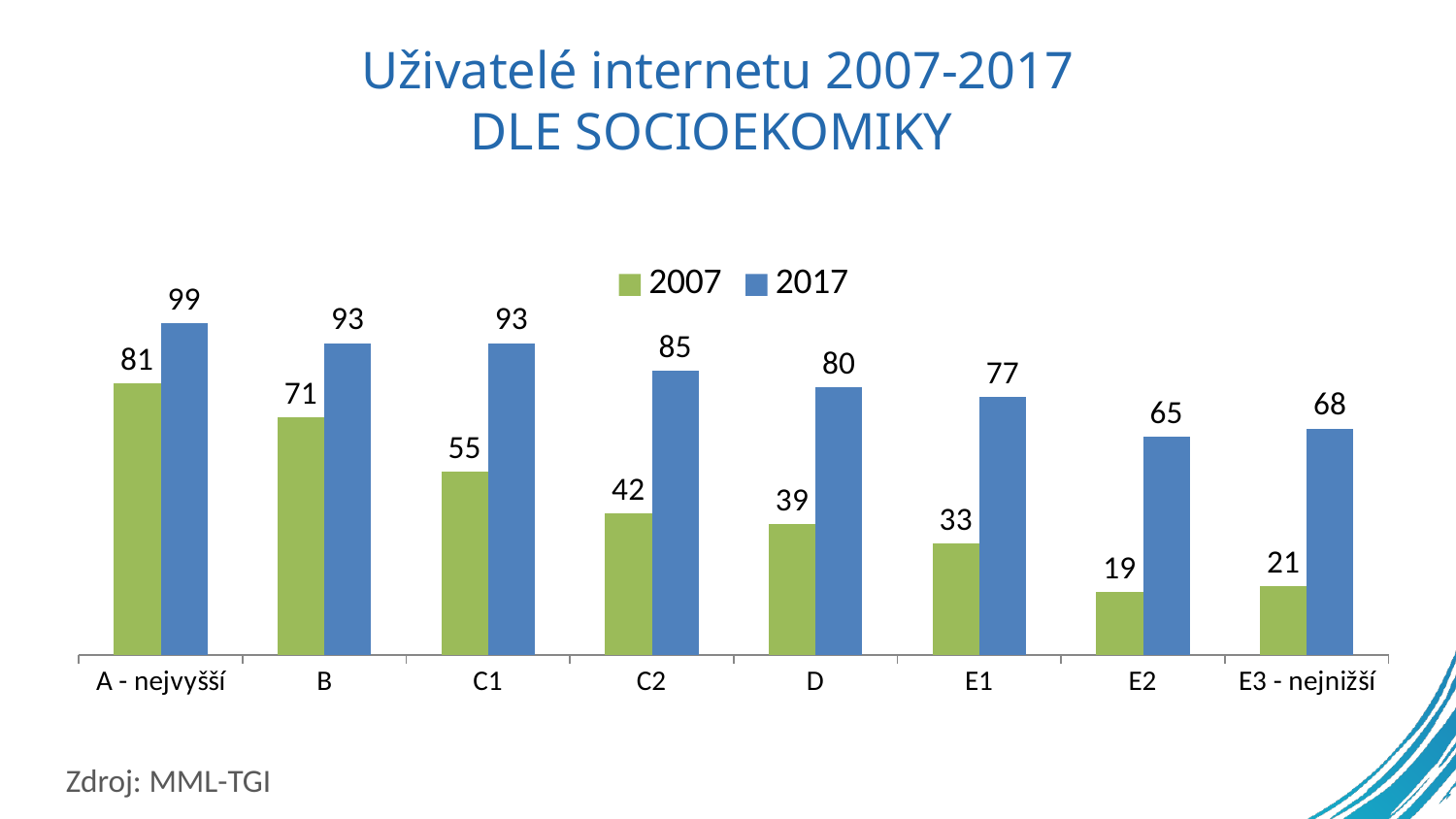
What is the 2007 value for category C1? 55 What is the difference between the 2017 and 2007 values for category E1? 44 Do the 2017 values generally rise or fall from A - nejvyšší to E2? Fall Which is larger: the 2007 value for B or the 2007 value for C2? 2007 value for B How many categories are shown on the x axis? 8 What is the 2017 value for category D? 80 What is the 2017 value for category E2? 65 What is the title of the chart? Uživatelé internetu 2007-2017 DLE SOCIOEKOMIKY Which category has the lowest 2007 value? E2 How many series does the legend list? 2 What kind of chart is shown on the slide? Bar chart Which category has the highest 2017 value? A - nejvyšší